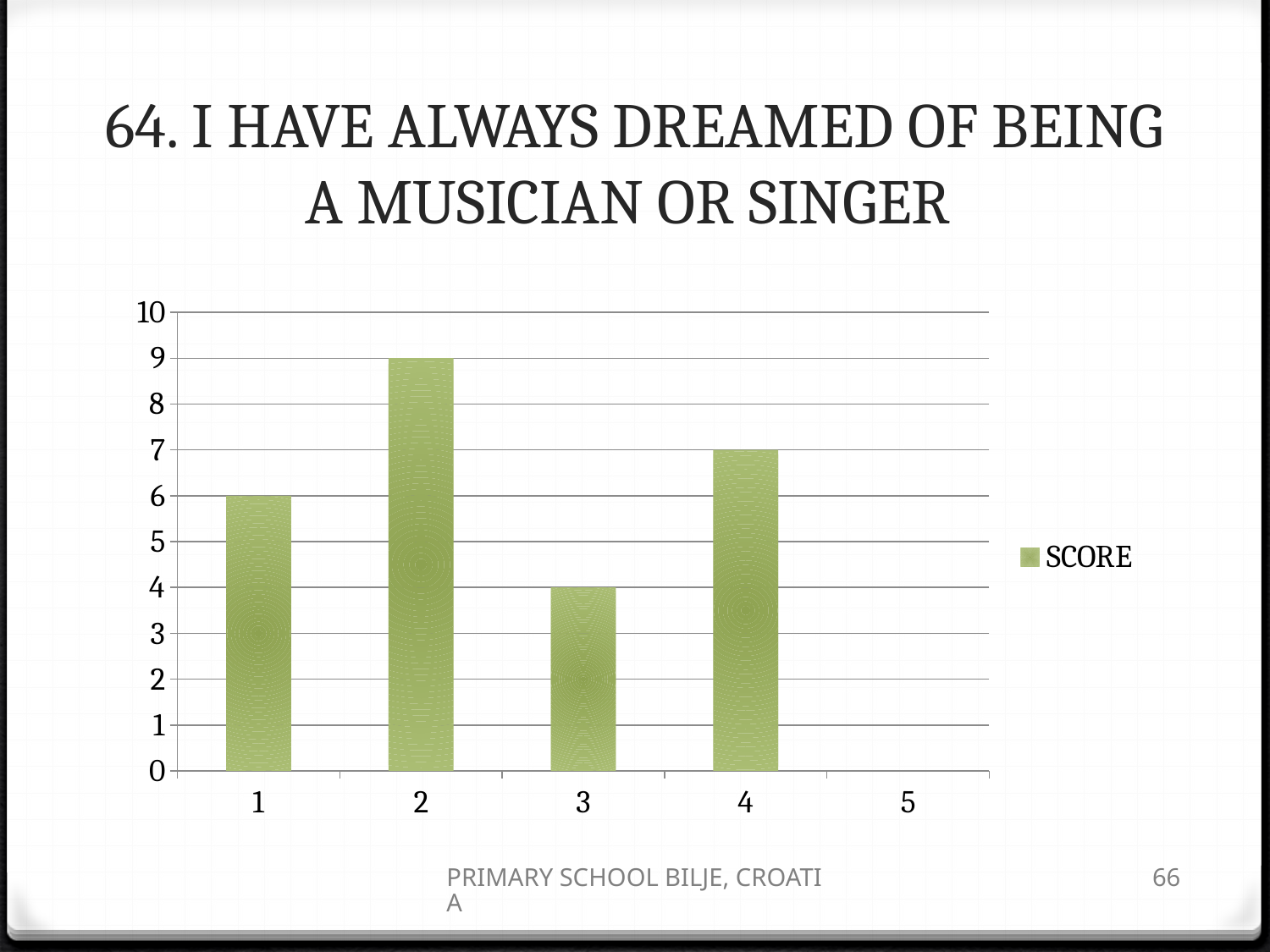
What is the SCORE value for category 4? 7 What kind of chart is shown on the slide? bar chart What is the SCORE value for category 3? 4 Which category has the highest SCORE? 2 What is the SCORE value for category 1? 6 Is the value for category 2 greater or less than 8? greater How many categories are shown on the x axis? 5 Which has a larger SCORE, category 1 or category 4? 4 Which category with a visible bar has the lowest SCORE? 3 How many series does the legend list? 1 What is the SCORE value for category 2? 9 What is the difference between the SCORE for category 2 and category 3? 5